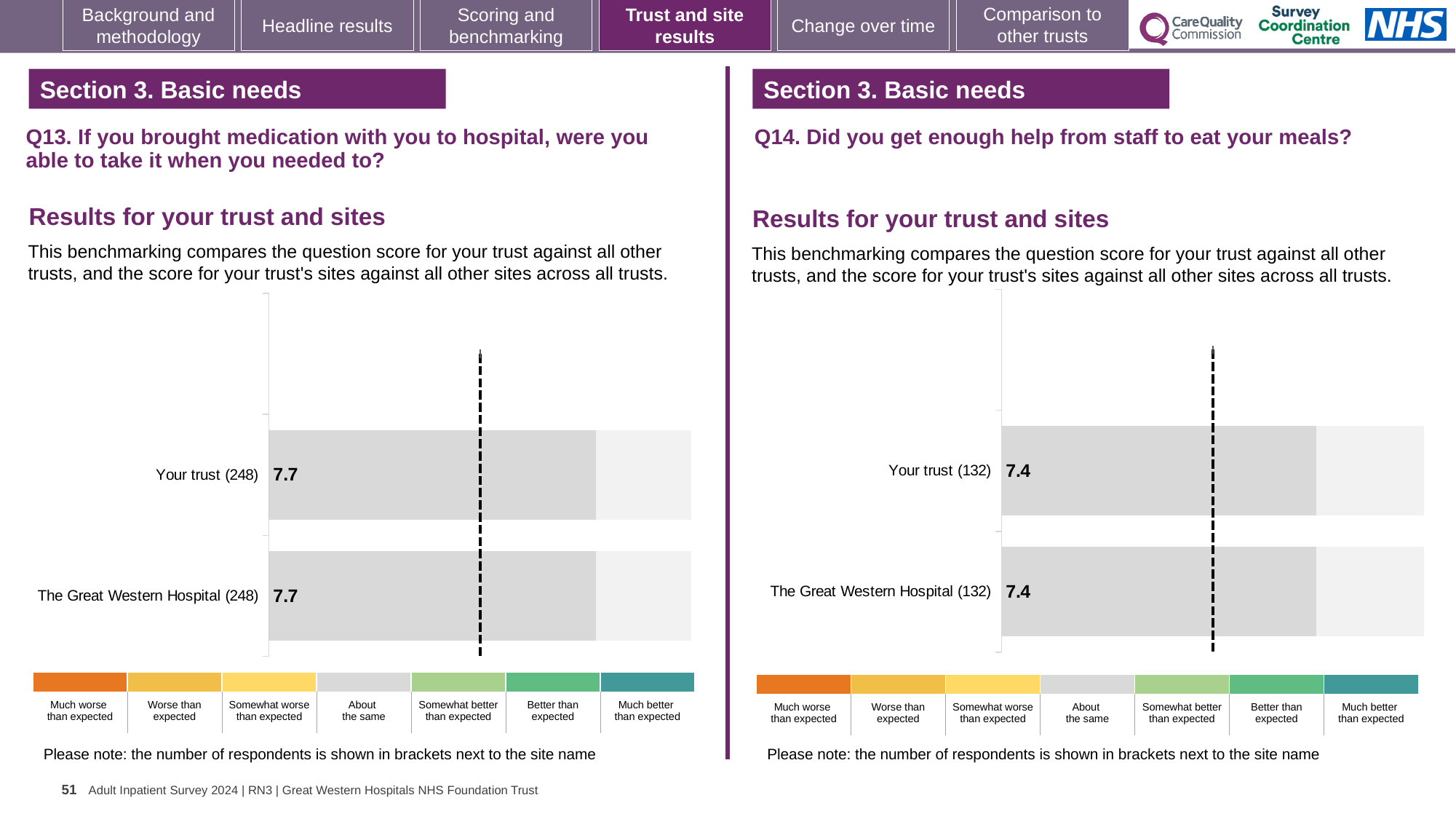
On the Q14 chart (right), how many categories (bars) are plotted? 2 Which is larger: the Your trust score on the Q13 chart (left) or the Your trust score on the Q14 chart (right)? Q13 chart (left) On the Q13 chart (left), how many categories (bars) are plotted? 2 On the Q14 chart (right), which benchmark category does the colour key label for the grey band? About the same On the Q13 chart (left), what is the score for The Great Western Hospital? 7.7 On the Q14 chart (right), what is the score for Your trust? 7.4 On the Q13 chart (left), what is the difference between the score for Your trust and the score for The Great Western Hospital? 0 On the Q14 chart (right), how many respondents are shown in brackets for The Great Western Hospital? 132 On the Q14 chart (right), what is the score for The Great Western Hospital? 7.4 On the Q13 chart (left), what is the score for Your trust? 7.7 On the Q13 chart (left), how many respondents are shown in brackets for Your trust? 248 What kind of chart is used on the Q13 chart (left)? Bar chart